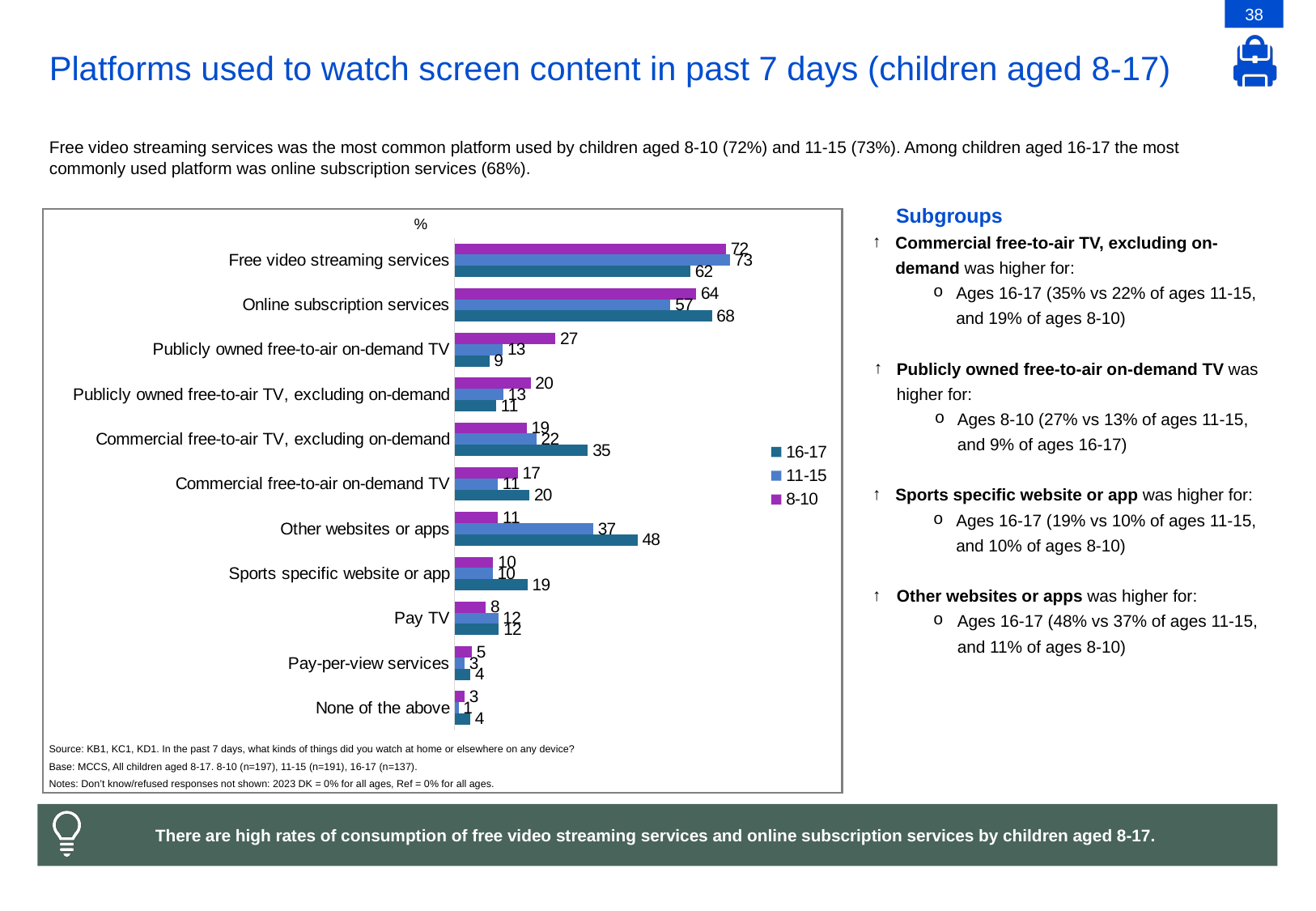
What kind of chart is shown on the slide? Bar chart What is the value for the 8-10 age group for Publicly owned free-to-air on-demand TV? 27 What is the value for the 16-17 age group for Free video streaming services? 62 Which platform has the highest value for the 16-17 age group? Online subscription services Which age group is shown in purple in the chart legend? 8-10 What is the value for the 11-15 age group for Other websites or apps? 37 How many platform categories are shown on the chart? 11 What is the difference between the 16-17 and 8-10 values for Other websites or apps? 37 How many series does the legend list? 3 Which is larger for Commercial free-to-air TV, excluding on-demand: the 16-17 value or the 8-10 value? 16-17 What is the difference between the 8-10 and 16-17 values for Publicly owned free-to-air on-demand TV? 18 Which platform has the lowest value for the 11-15 age group? None of the above